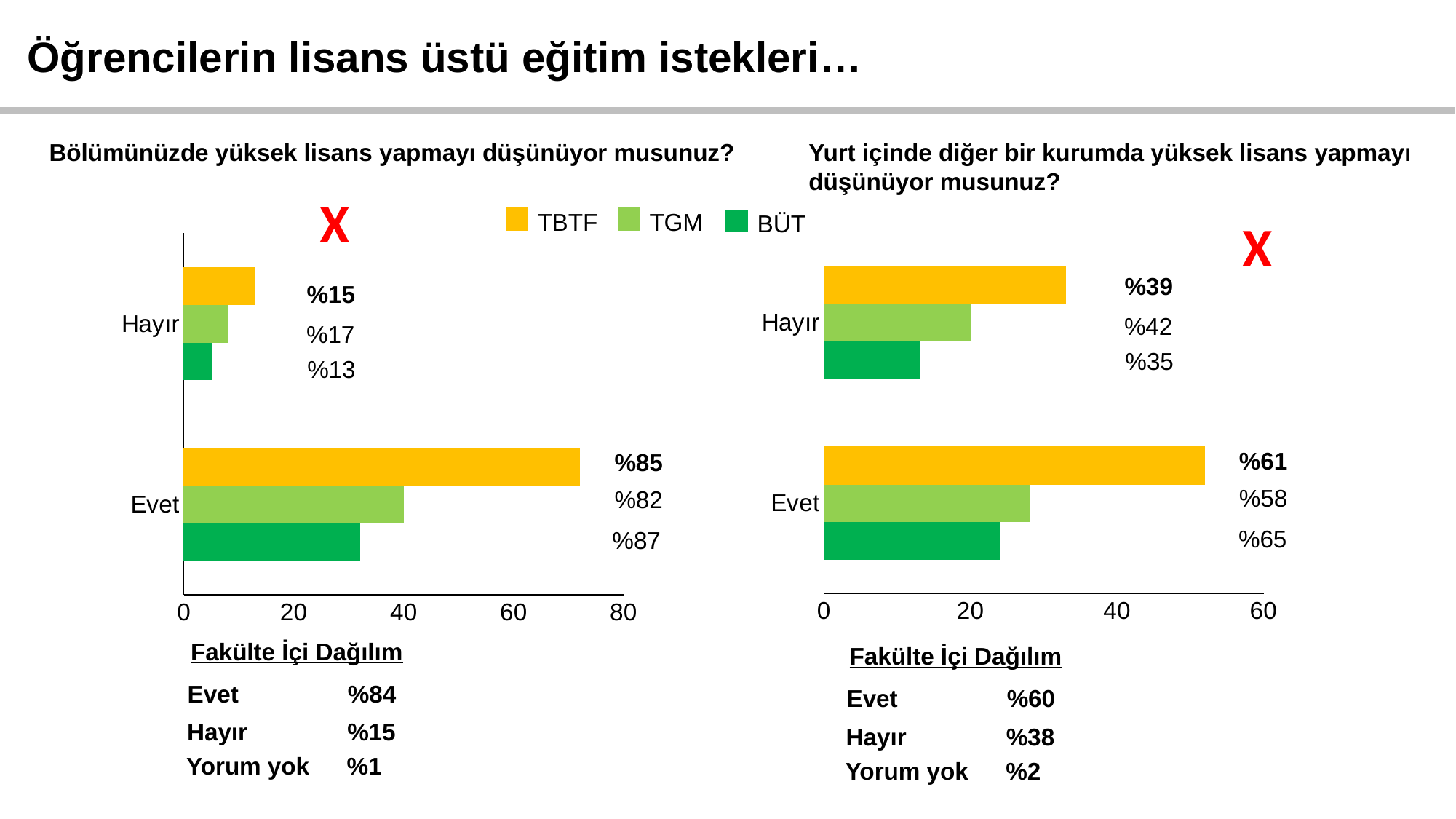
In the left chart (Bölümünüzde yüksek lisans yapmayı düşünüyor musunuz?), what is the value for TBTF in the Evet category? %85 What kind of chart is the right chart (Yurt içinde diğer bir kurumda yüksek lisans yapmayı düşünüyor musunuz?)? Bar chart In the left chart (Bölümünüzde yüksek lisans yapmayı düşünüyor musunuz?), what is the value for TGM in the Hayır category? %17 In the right chart (Yurt içinde diğer bir kurumda yüksek lisans yapmayı düşünüyor musunuz?), what is the value for TBTF in the Hayır category? %39 In the left chart (Bölümünüzde yüksek lisans yapmayı düşünüyor musunuz?), what is the difference between the TBTF and TGM values in the Evet category? 3 How many series does the legend list for the charts on this slide? 3 In the right chart (Yurt içinde diğer bir kurumda yüksek lisans yapmayı düşünüyor musunuz?), which series has the lowest value in the Hayır category? BÜT In the right chart (Yurt içinde diğer bir kurumda yüksek lisans yapmayı düşünüyor musunuz?), what is the value for BÜT in the Evet category? %65 How many categories are shown on the y axis of the left chart (Bölümünüzde yüksek lisans yapmayı düşünüyor musunuz?)? 2